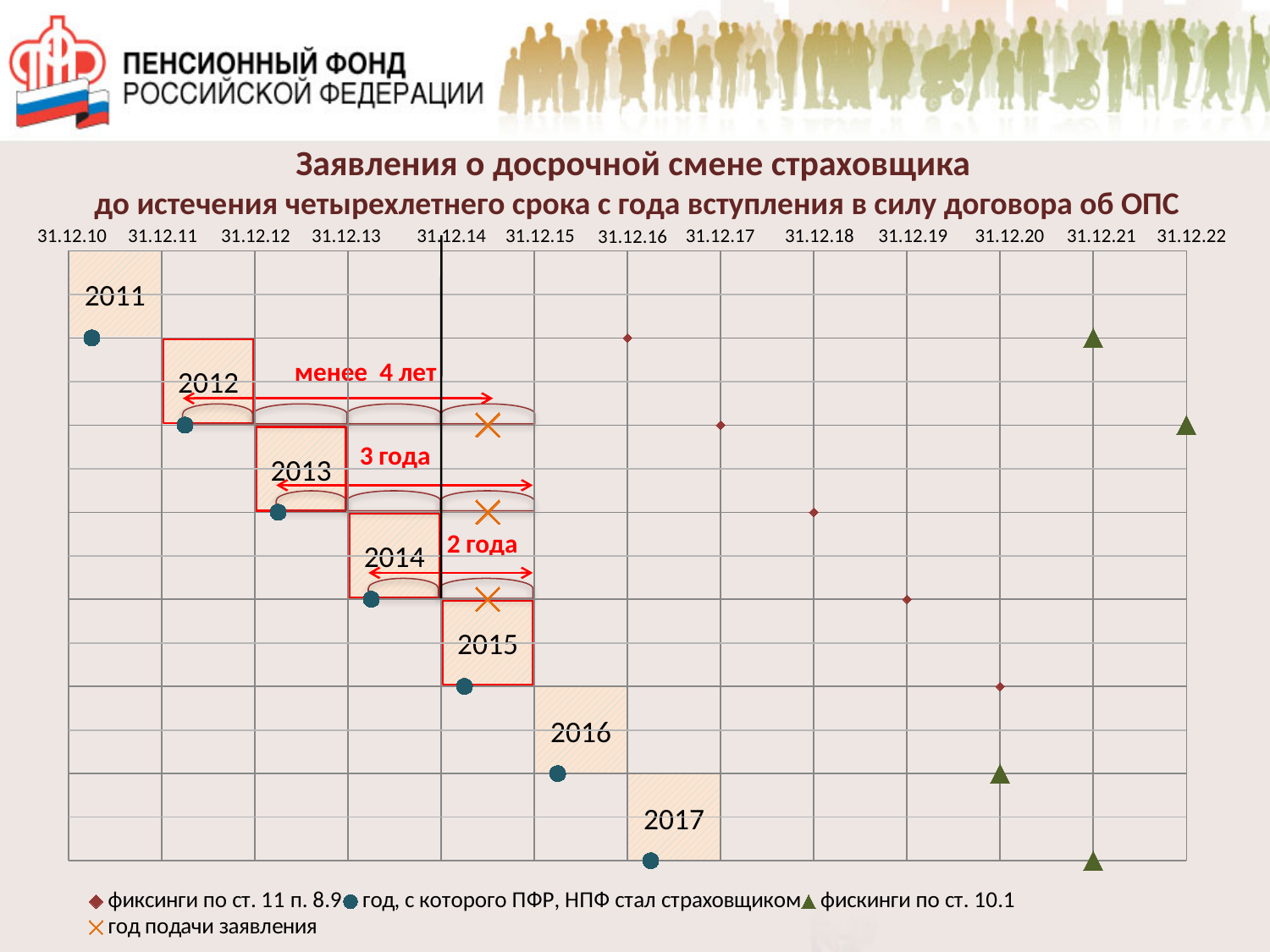
What kind of chart is shown on the slide? scatter chart What annotation is written above the arrow starting from the 2012 block? менее 4 лет What is the first date tick on the x axis? 31.12.10 How many year labels (2011, 2012, ...) are shown in the chart? 7 Which marker shape does the legend use for "фиксинги по ст. 10.1"? triangle How many series does the legend list? 4 What is the first line of the chart's title? Заявления о досрочной смене страховщика What annotation is written above the arrow starting from the 2014 block? 2 года How many "год подачи заявления" (X) markers are plotted? 3 How many date ticks are shown along the x axis? 13 What annotation is written above the arrow starting from the 2013 block? 3 года What is the last date tick on the x axis? 31.12.22